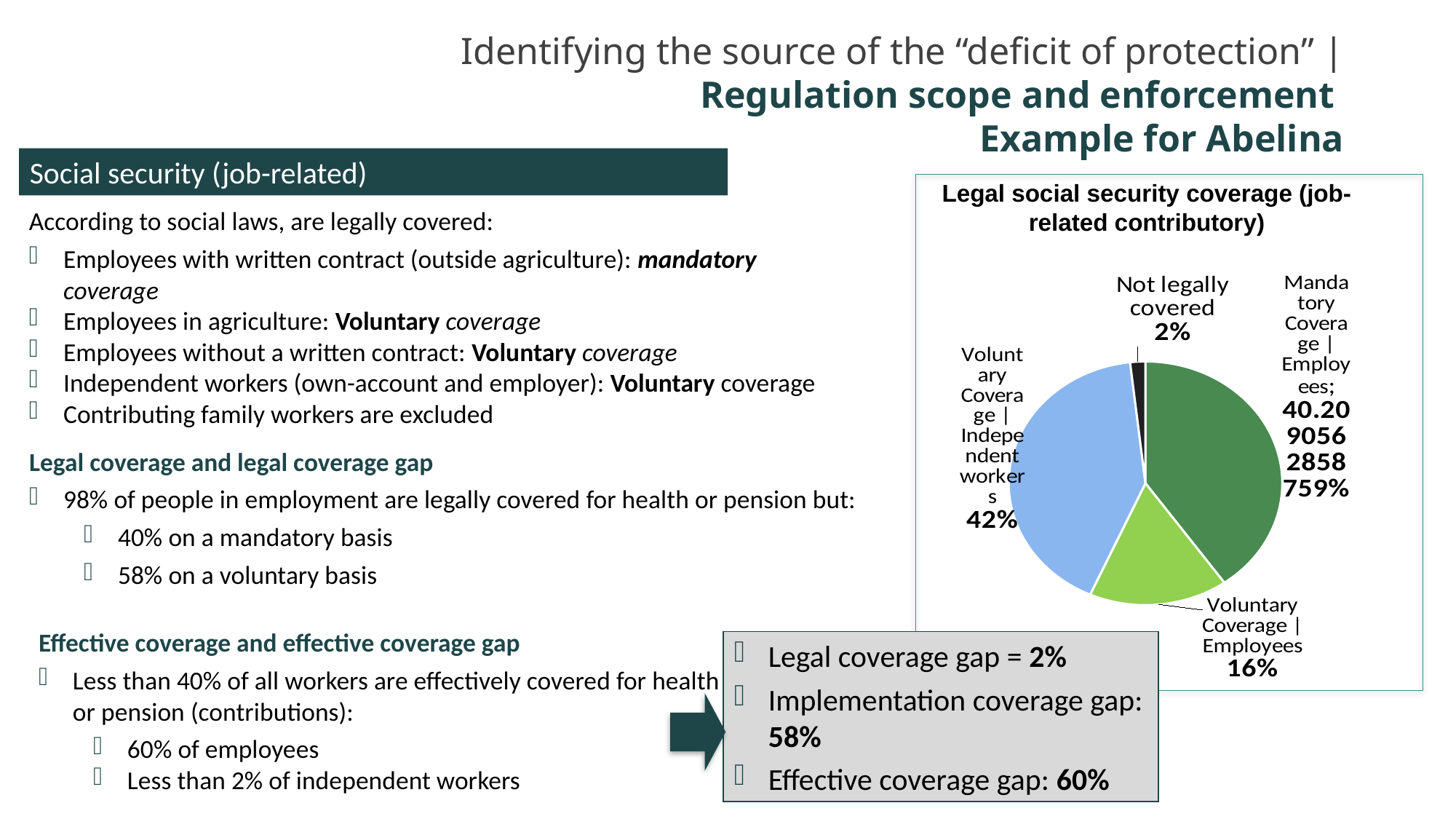
What share of the pie is labelled "Voluntary Coverage | Independent workers"? 42% What share of the pie is labelled "Voluntary Coverage | Employees"? 16% What kind of chart is shown on the slide? Pie chart Is the share for "Mandatory Coverage | Employees" greater or less than 30%? greater Which slice of the pie chart is coloured dark green? Mandatory Coverage | Employees What is the difference in percentage points between the "Voluntary Coverage | Independent workers" slice and the "Voluntary Coverage | Employees" slice? 26 percentage points Which slice of the pie chart is the largest? Voluntary Coverage | Independent workers How many slices does the pie chart have? 4 Which is larger: the "Voluntary Coverage | Employees" slice or the "Not legally covered" slice? Voluntary Coverage | Employees What is the title of the chart? Legal social security coverage (job-related contributory) Which slice of the pie chart is the smallest? Not legally covered What share of the pie is labelled "Not legally covered"? 2%